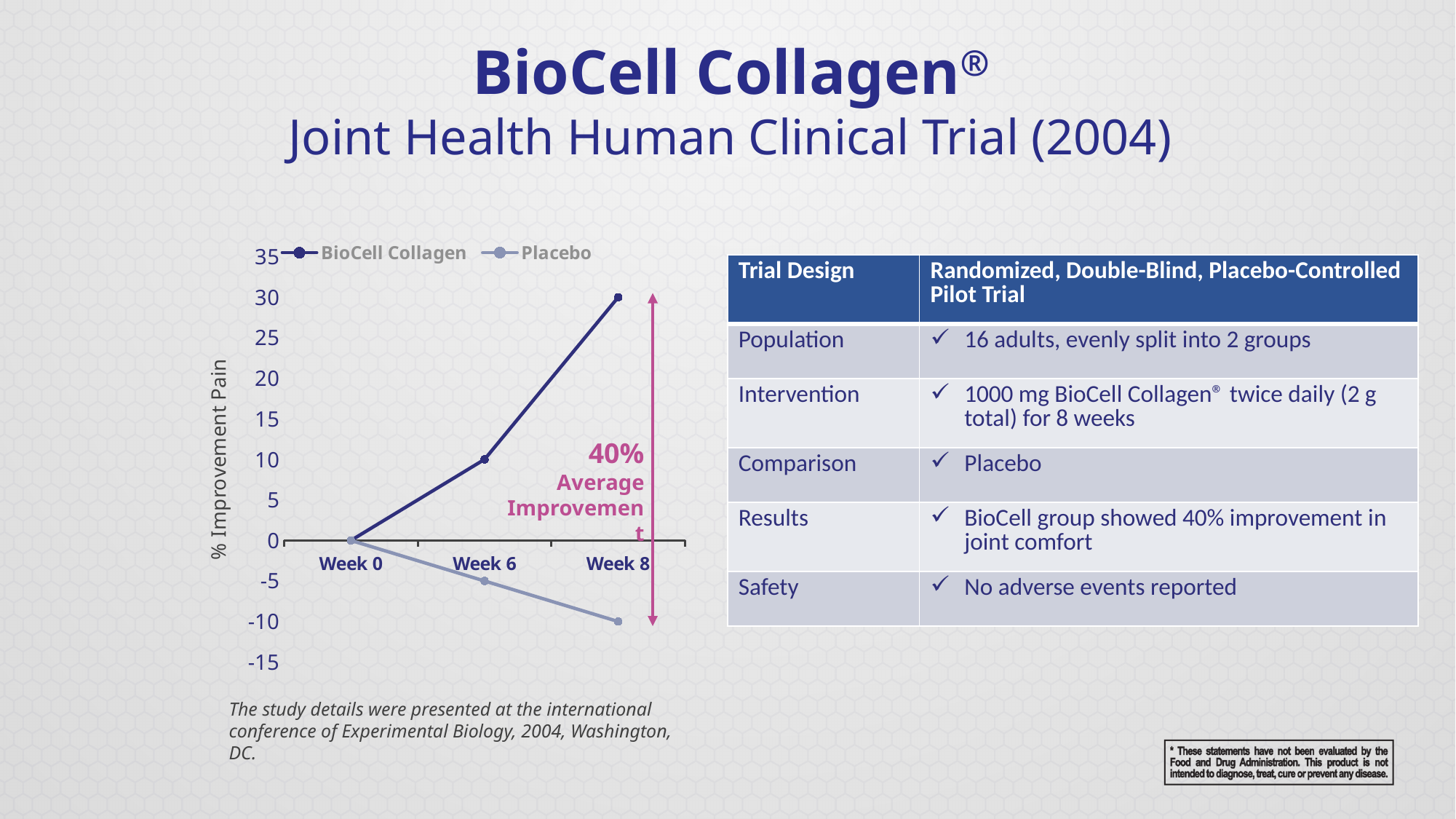
Does the Placebo line rise or fall from Week 0 to Week 8? Fall What kind of chart is shown on the slide? Line chart Does the BioCell Collagen line rise or fall from Week 0 to Week 8? Rise What is the difference between the BioCell Collagen and Placebo values at Week 8? 40 What is the label on the y axis of the chart? % Improvement Pain How many series does the chart legend list? 2 What is the value for Placebo at Week 6? -5 What is the value for BioCell Collagen at Week 8? 30 Which series has the higher value at Week 6, BioCell Collagen or Placebo? BioCell Collagen What is the value for Placebo at Week 8? -10 How many time points are plotted along the x axis of the chart? 3 What is the value for BioCell Collagen at Week 6? 10